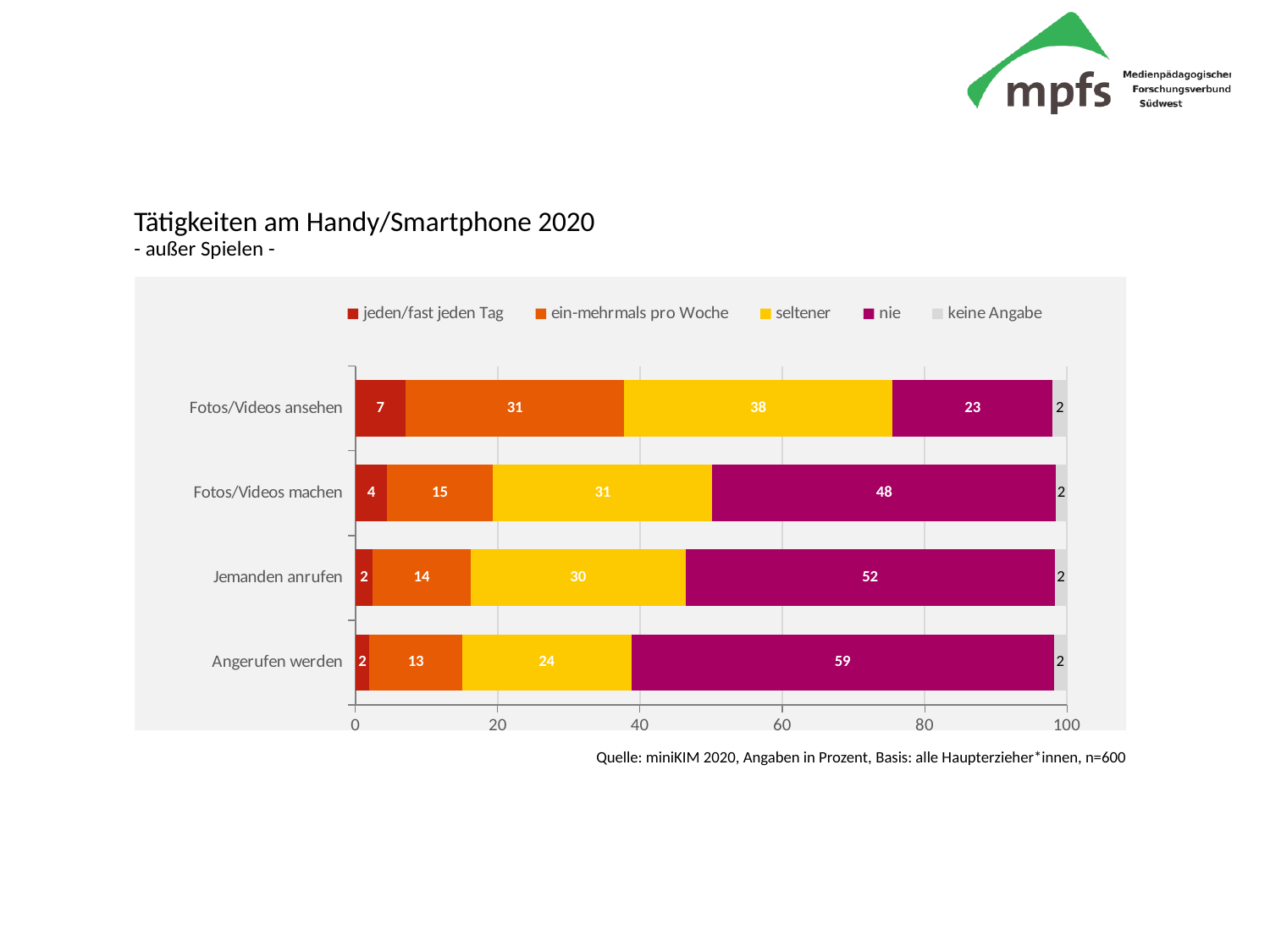
How many categories are shown on the y axis? 4 Which is larger: the "seltener" value for Fotos/Videos machen or for Angerufen werden? Fotos/Videos machen What is the value for "seltener" for Fotos/Videos ansehen? 38 What is the difference between the "nie" values for Jemanden anrufen and Fotos/Videos machen? 4 What is the value for "nie" for Angerufen werden? 59 Which category has the highest value for "nie"? Angerufen werden What kind of chart is this? stacked bar chart Which category has the lowest value for "nie"? Fotos/Videos ansehen What is the total of the stacked bar for Fotos/Videos ansehen? 101 What is the title of the chart? Tätigkeiten am Handy/Smartphone 2020 - außer Spielen - How many series does the legend list? 5 What is the value for "ein-mehrmals pro Woche" for Fotos/Videos machen? 15